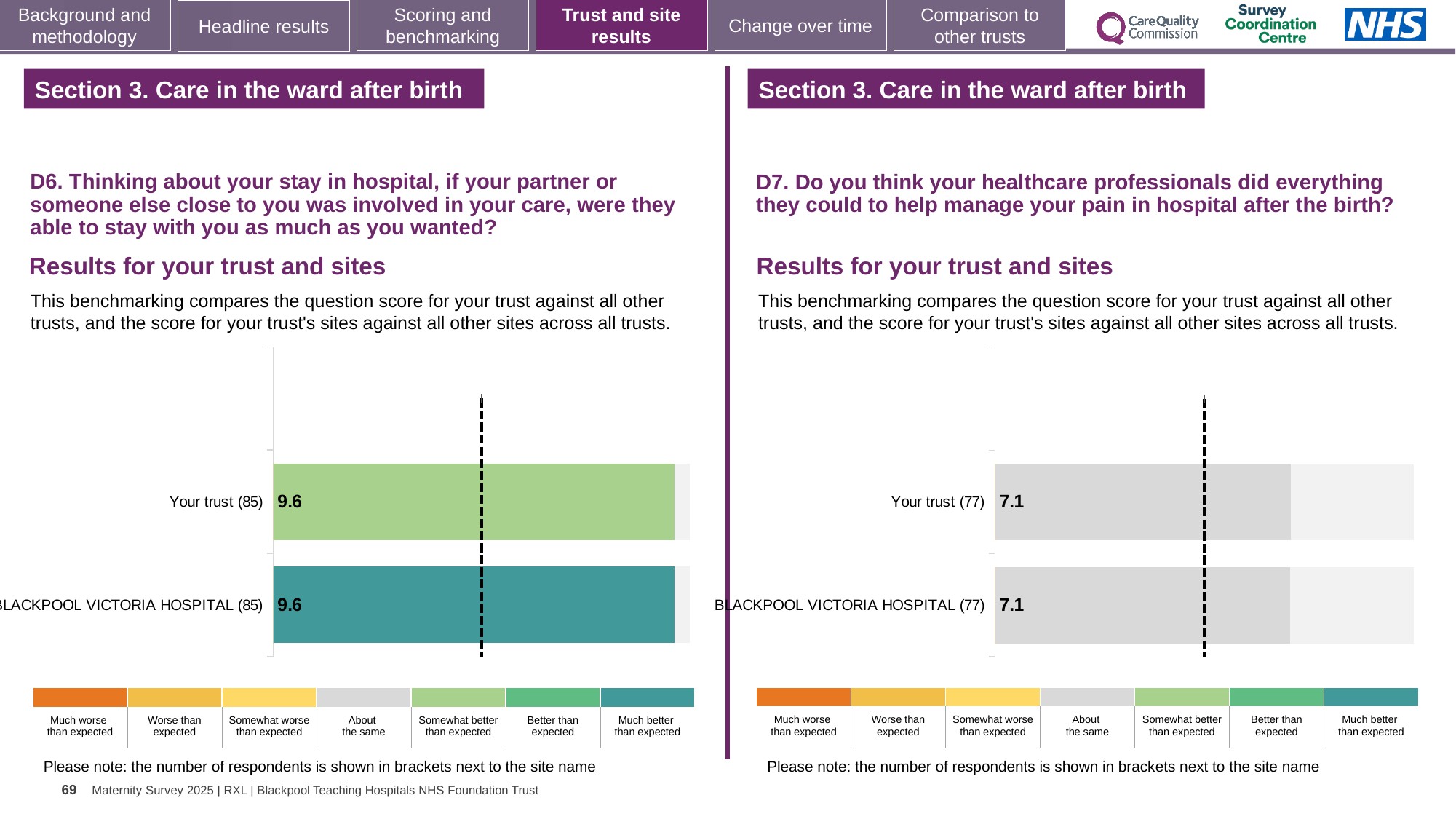
What kind of chart is used on the D7 chart (right)? Bar chart On the D6 chart (left), what is the score for BLACKPOOL VICTORIA HOSPITAL (85)? 9.6 On the D6 chart (left), what is the difference between the score for Your trust and the score for BLACKPOOL VICTORIA HOSPITAL? 0 How many bars are plotted on the D6 chart (left)? 2 On the D7 chart (right), how many respondents are shown in brackets next to BLACKPOOL VICTORIA HOSPITAL? 77 On the D7 chart (right), what is the score for Your trust (77)? 7.1 On the D7 chart (right), what is the difference between the score for Your trust and the score for BLACKPOOL VICTORIA HOSPITAL? 0 On the D6 chart (left), what is the score for Your trust (85)? 9.6 How many bars are plotted on the D7 chart (right)? 2 On the D6 chart (left), how many respondents are shown in brackets next to Your trust? 85 On the D7 chart (right), what is the score for BLACKPOOL VICTORIA HOSPITAL (77)? 7.1